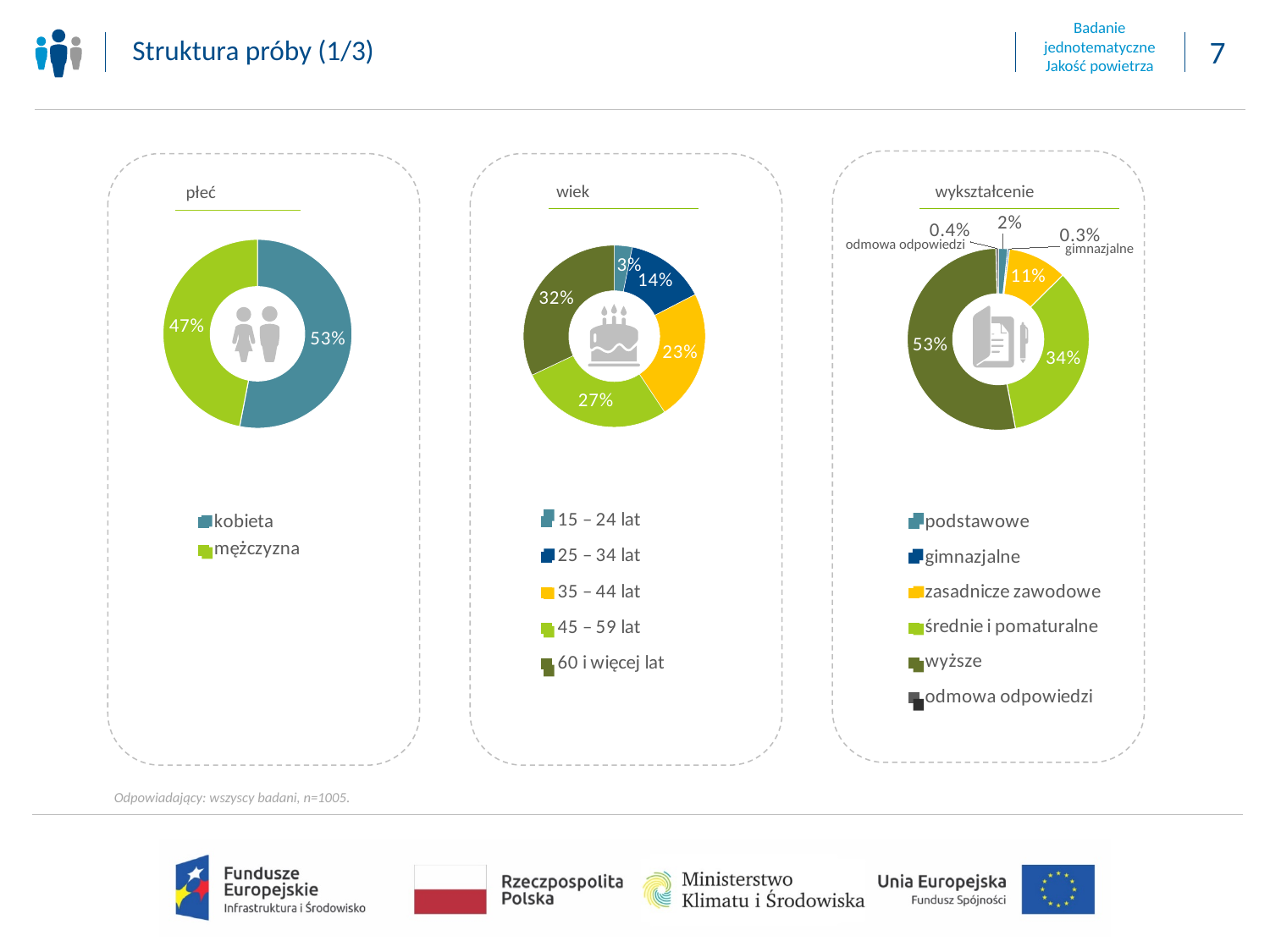
In the 'płeć' chart, what share is labelled for mężczyzna? 47% In the 'wykształcenie' chart, which category has the largest share? wyższe In the 'wykształcenie' chart, which is larger: zasadnicze zawodowe or średnie i pomaturalne? średnie i pomaturalne In the 'wiek' chart, what is the difference between the 45 – 59 lat share and the 35 – 44 lat share? 4 percentage points In the 'wiek' chart, what share is shown for the 60 i więcej lat group? 32% In the 'wykształcenie' chart, what share is shown for gimnazjalne? 0.3% In the 'wykształcenie' chart, what share is shown for odmowa odpowiedzi? 0.4% What type of chart is used for the 'płeć' data? Donut (pie) chart In the 'wykształcenie' chart, what share is shown for wyższe? 53% In the 'wiek' chart, which age group has the smallest share? 15 – 24 lat In the 'wiek' chart, how many age categories does the legend list? 5 In the 'płeć' chart, what share is labelled for kobieta? 53%